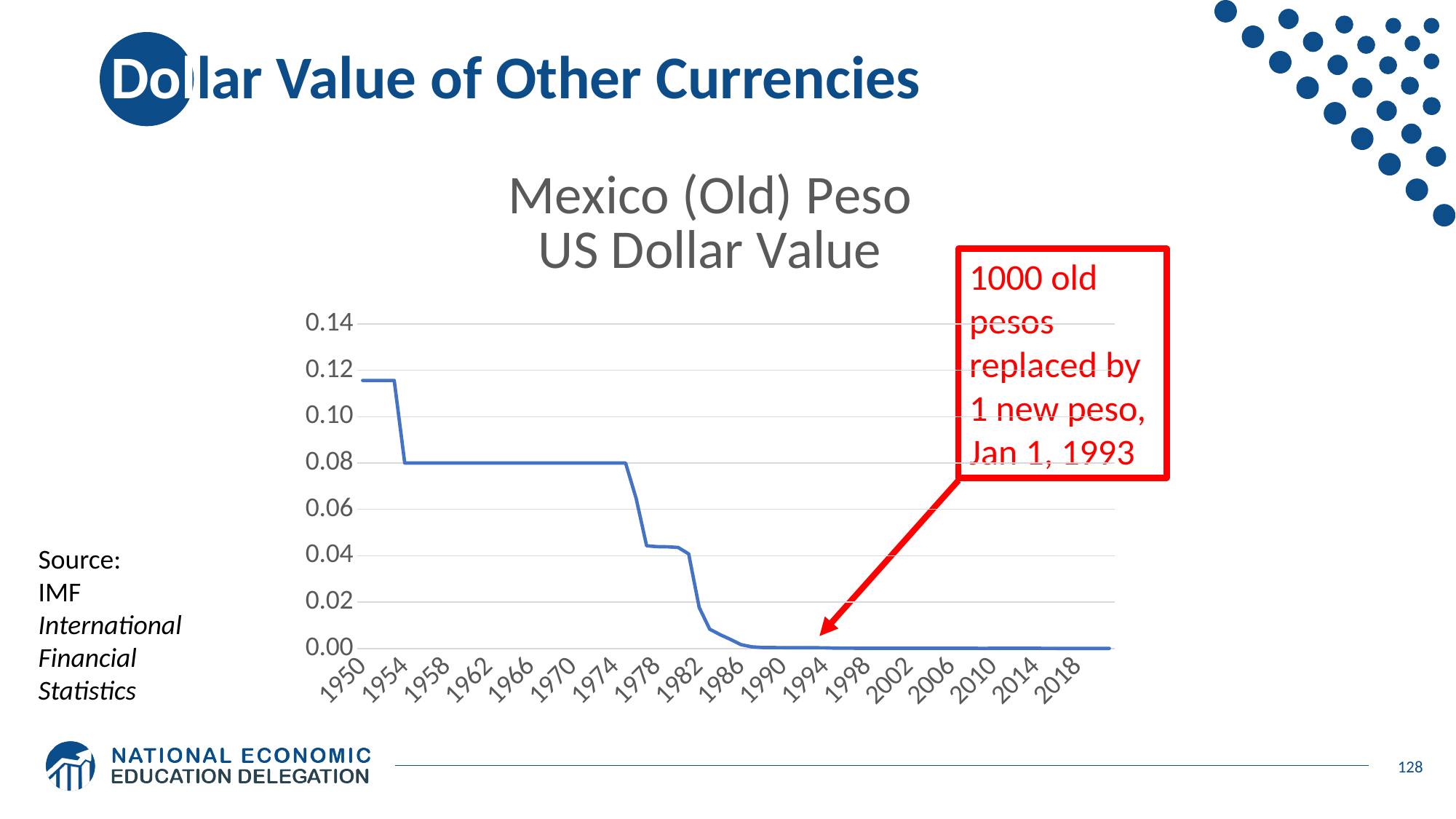
How many year labels are shown on the x axis? 18 Is the value for 1980 greater or less than 0.06? less Is the value for 1990 greater or less than 0.02? less In which year shown on the x axis is the value highest? 1950 What kind of chart is shown on the slide? line chart Is the value for 1962 greater or less than 0.10? less What is the highest value shown on the y axis? 0.14 What is the title of the chart? Mexico (Old) Peso US Dollar Value Which is larger, the value for 1958 or the value for 1986? 1958 Overall, does the US dollar value of the Mexican old peso rise or fall from 1950 to 2018? fall